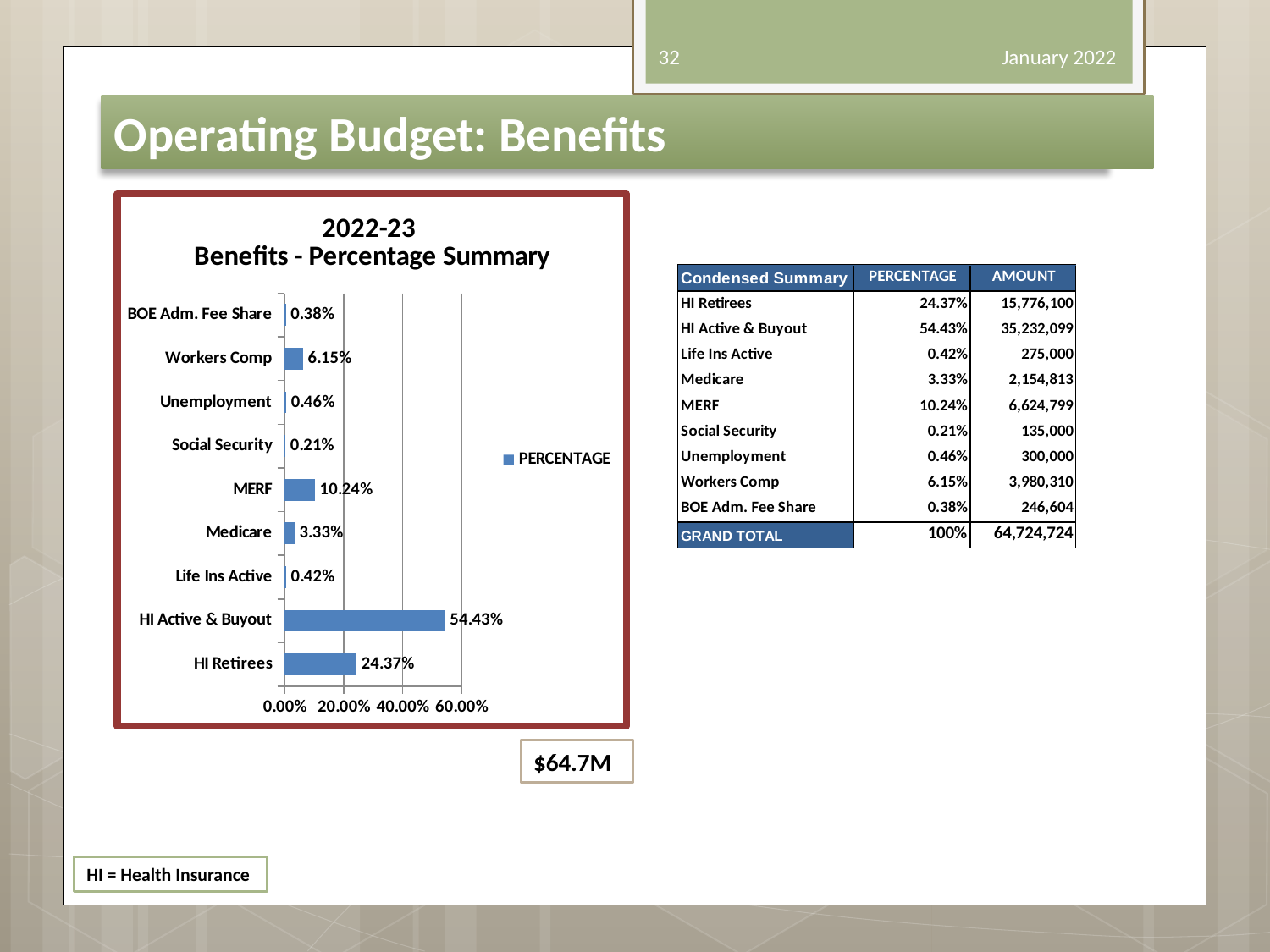
What is the value for MERF in the 2022-23 Benefits - Percentage Summary chart? 10.24% How many categories are shown in the 2022-23 Benefits - Percentage Summary chart? 9 What is the name of the series shown in the legend of the 2022-23 Benefits - Percentage Summary chart? PERCENTAGE Which category has the lowest value in the 2022-23 Benefits - Percentage Summary chart? Social Security How many series does the legend list in the 2022-23 Benefits - Percentage Summary chart? 1 What kind of chart is the 2022-23 Benefits - Percentage Summary chart? bar chart What is the value for HI Active & Buyout in the 2022-23 Benefits - Percentage Summary chart? 54.43% What is the difference between the values for HI Active & Buyout and HI Retirees in the 2022-23 Benefits - Percentage Summary chart? 30.06% Which is larger in the 2022-23 Benefits - Percentage Summary chart, Medicare or Workers Comp? Workers Comp Is the value for HI Retirees in the 2022-23 Benefits - Percentage Summary chart greater or less than 20.00%? greater Which category has the highest value in the 2022-23 Benefits - Percentage Summary chart? HI Active & Buyout What is the value for Workers Comp in the 2022-23 Benefits - Percentage Summary chart? 6.15%